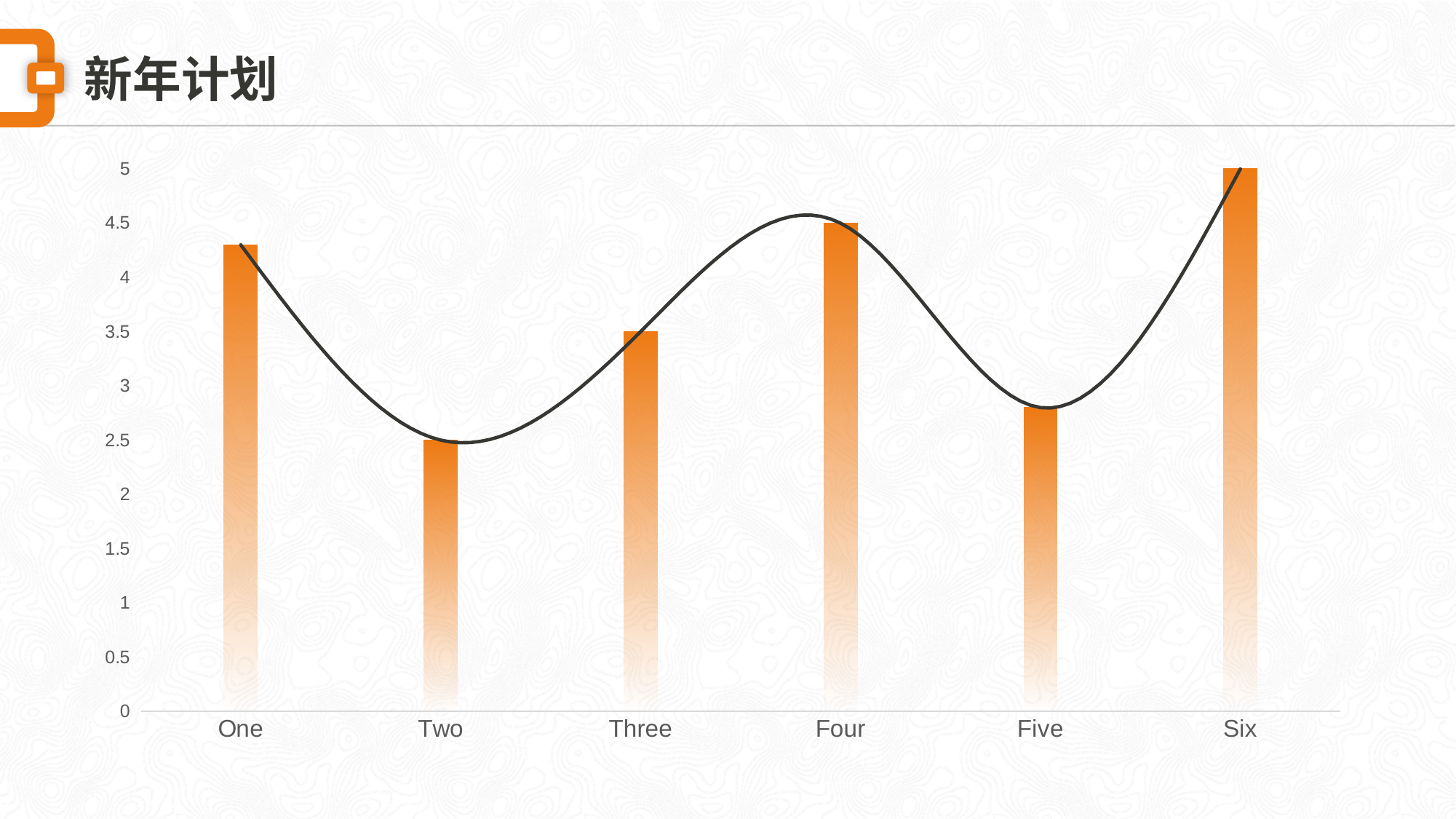
What is the value for Six? 5 Which category has the lowest value? Two What is the value for Four? 4.5 What is the value for Three? 3.5 Which category has the highest value? Six What is the title of the slide containing the chart? 新年计划 Is the value for One greater or less than 4? greater What is the difference between the values for Four and Two? 2 How many categories are shown on the x axis? 6 Which is larger, the value for Three or the value for Five? Three What is the value for Two? 2.5 Is the value for Five greater or less than 3? less